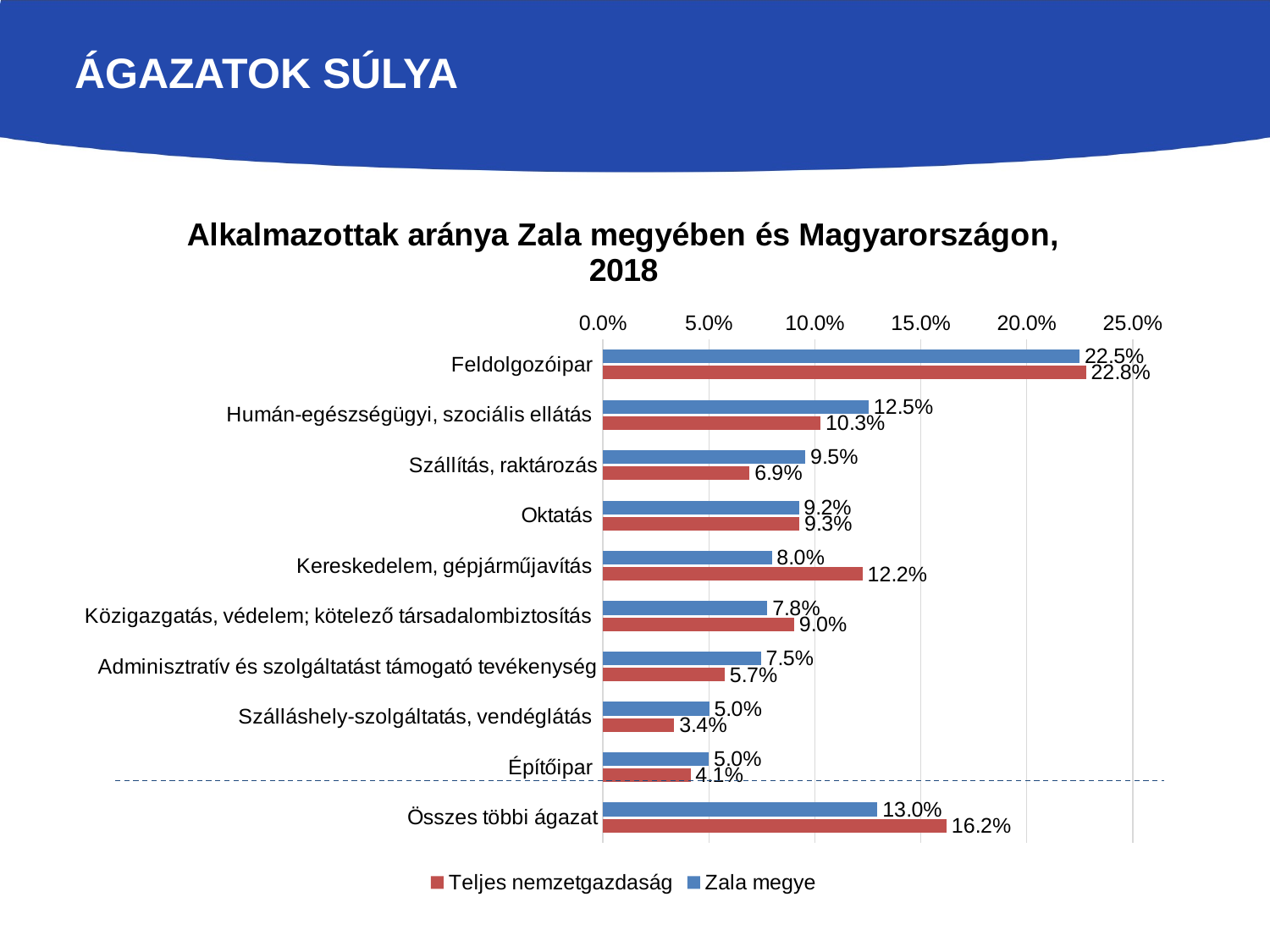
How many categories are shown on the chart? 10 What is the difference between the Zala megye and Teljes nemzetgazdaság values for Szállítás, raktározás? 2.6% What is the Zala megye value for Feldolgozóipar? 22.5% What is the Teljes nemzetgazdaság value for Szálláshely-szolgáltatás, vendéglátás? 3.4% What is the Zala megye value for Összes többi ágazat? 13.0% What is the Teljes nemzetgazdaság value for Kereskedelem, gépjárműjavítás? 12.2% For Humán-egészségügyi, szociális ellátás, which is larger: the Zala megye value or the Teljes nemzetgazdaság value? Zala megye How many series does the legend list? 2 Is the Teljes nemzetgazdaság value for Összes többi ágazat greater or less than 15.0%? greater Which category has the highest Zala megye value? Feldolgozóipar Which category has the lowest Teljes nemzetgazdaság value? Szálláshely-szolgáltatás, vendéglátás What kind of chart is shown on the slide? Bar chart